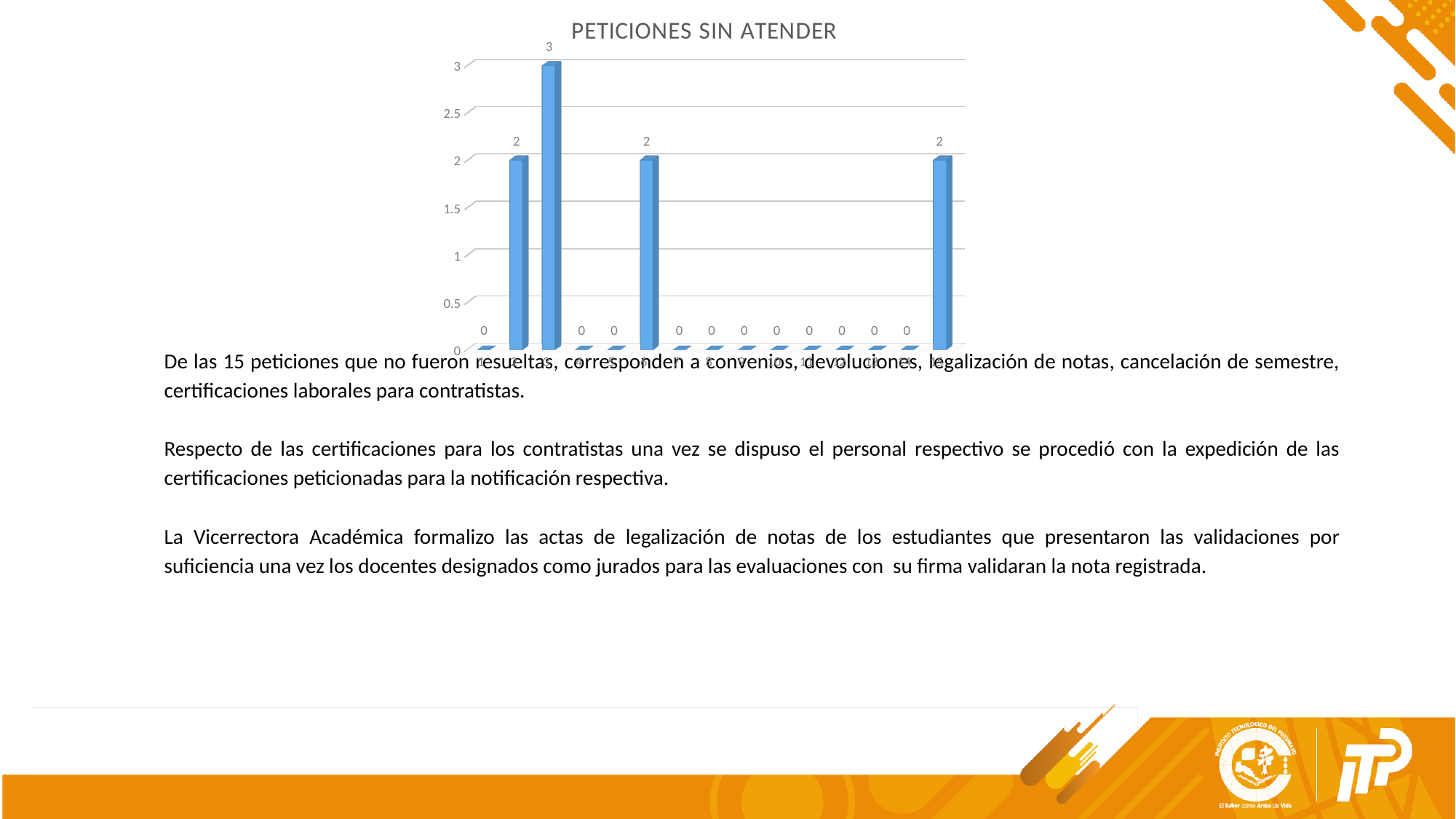
What is the value of the rightmost bar? 2 What kind of chart is shown on the slide? bar chart What is the value of the leftmost bar? 0 What is the highest value shown in the chart? 3 What is the value of the third bar from the left? 3 What is the value of the second bar from the left? 2 How many categories (bars) are plotted in the chart? 15 How many bars have a value of 2? 3 Is the value of the tallest bar greater or less than 2.5? greater What is the difference between the tallest bar and the second bar from the left? 1 Which is larger, the second bar from the left or the third bar from the left? the third bar What is the title of the chart? PETICIONES SIN ATENDER